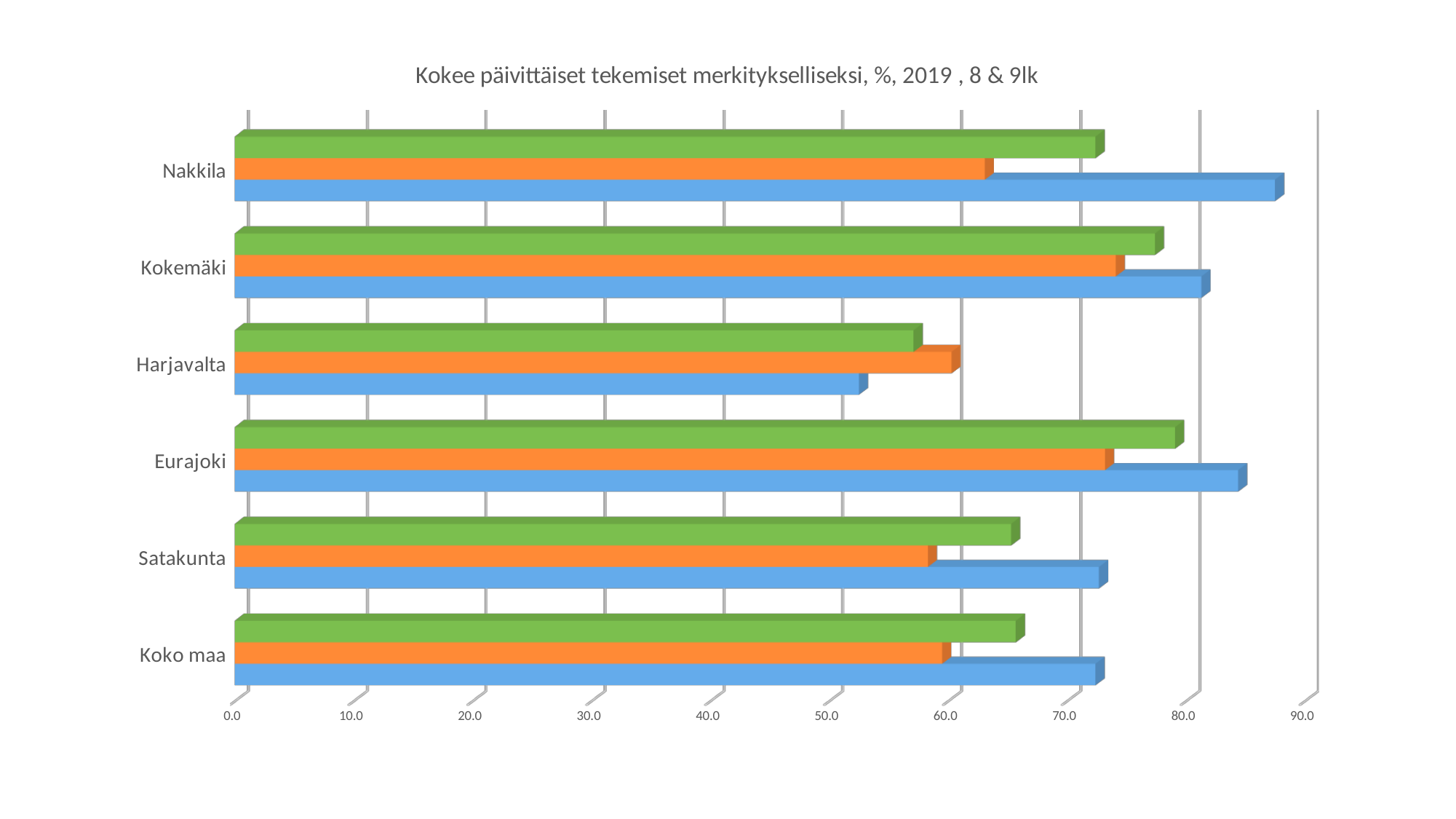
How many bars are plotted for each category in the chart? 3 Is the green bar for Kokemäki greater or less than 70.0? greater Which category has the shortest green bar? Harjavalta Is the orange bar for Satakunta greater or less than 50.0? greater For Harjavalta, which is larger: the orange bar or the blue bar? the orange bar What kind of chart is shown on the slide? bar chart Is the blue bar for Harjavalta greater or less than 60.0? less What is the title of the chart? Kokee päivittäiset tekemiset merkitykselliseksi, %, 2019 , 8 & 9lk Which category has the longest blue bar? Nakkila How many categories are shown on the vertical axis of the chart? 6 Which category has the shortest blue bar? Harjavalta